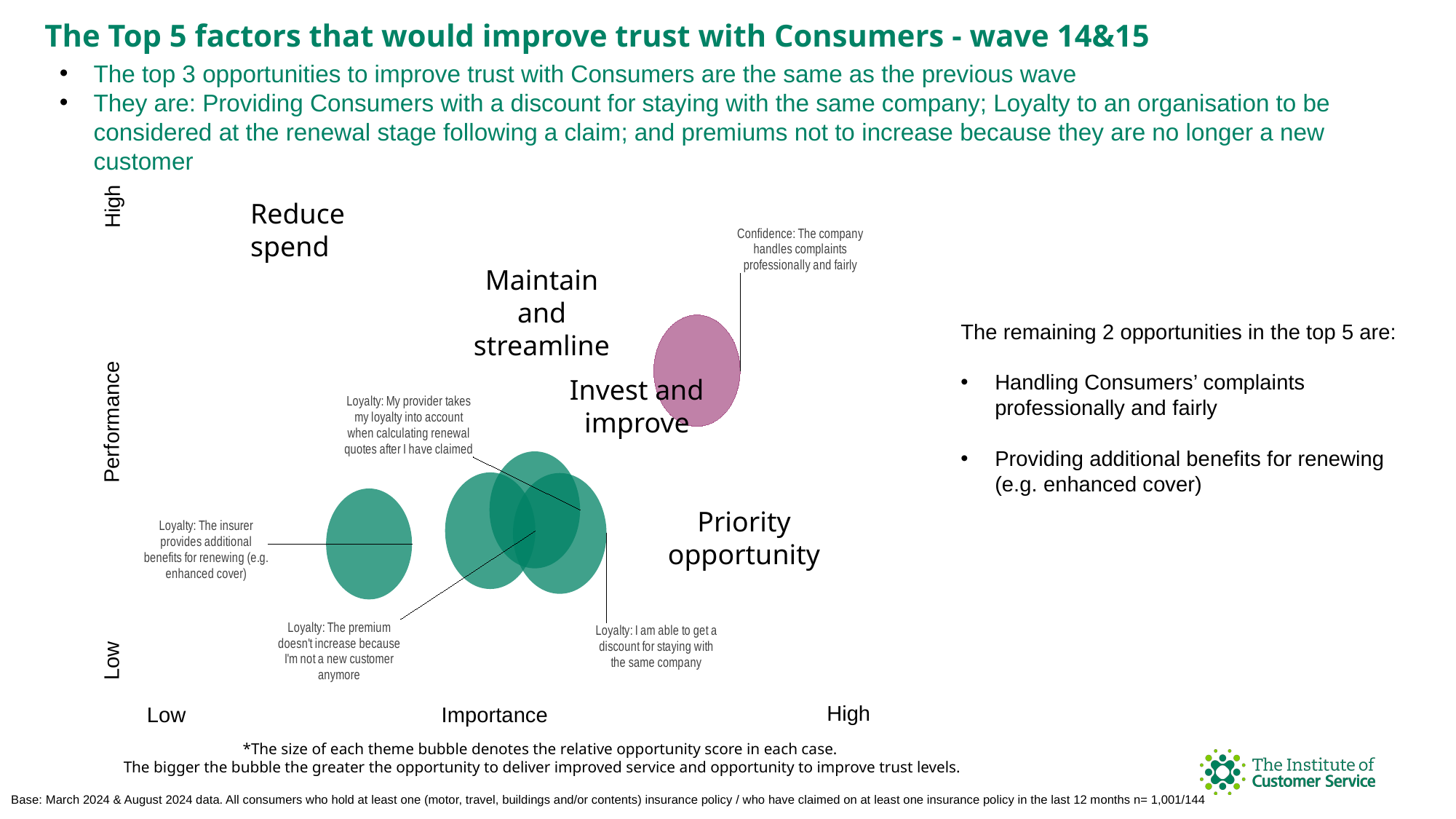
Which is further right on the Importance axis: the 'Loyalty: The insurer provides additional benefits for renewing' bubble or the 'Loyalty: I am able to get a discount for staying with the same company' bubble? Loyalty: I am able to get a discount for staying with the same company Which bubble is coloured purple rather than green? Confidence: The company handles complaints professionally and fairly How many bubbles are plotted on the chart? 5 What is the label of the vertical axis of the chart? Performance How many bubbles on the chart are coloured green? 4 Which bubble is positioned highest on the Performance axis? Confidence: The company handles complaints professionally and fairly Which is higher on the Performance axis: the 'Confidence: The company handles complaints professionally and fairly' bubble or the 'Loyalty: I am able to get a discount for staying with the same company' bubble? Confidence: The company handles complaints professionally and fairly Which quadrant label appears in the top-left area of the chart? Reduce spend What is the label of the horizontal axis of the chart? Importance Which bubble is positioned furthest to the left (lowest Importance)? Loyalty: The insurer provides additional benefits for renewing (e.g. enhanced cover) Which bubble is positioned furthest to the right (highest Importance)? Confidence: The company handles complaints professionally and fairly What kind of chart is shown on the slide? Bubble chart